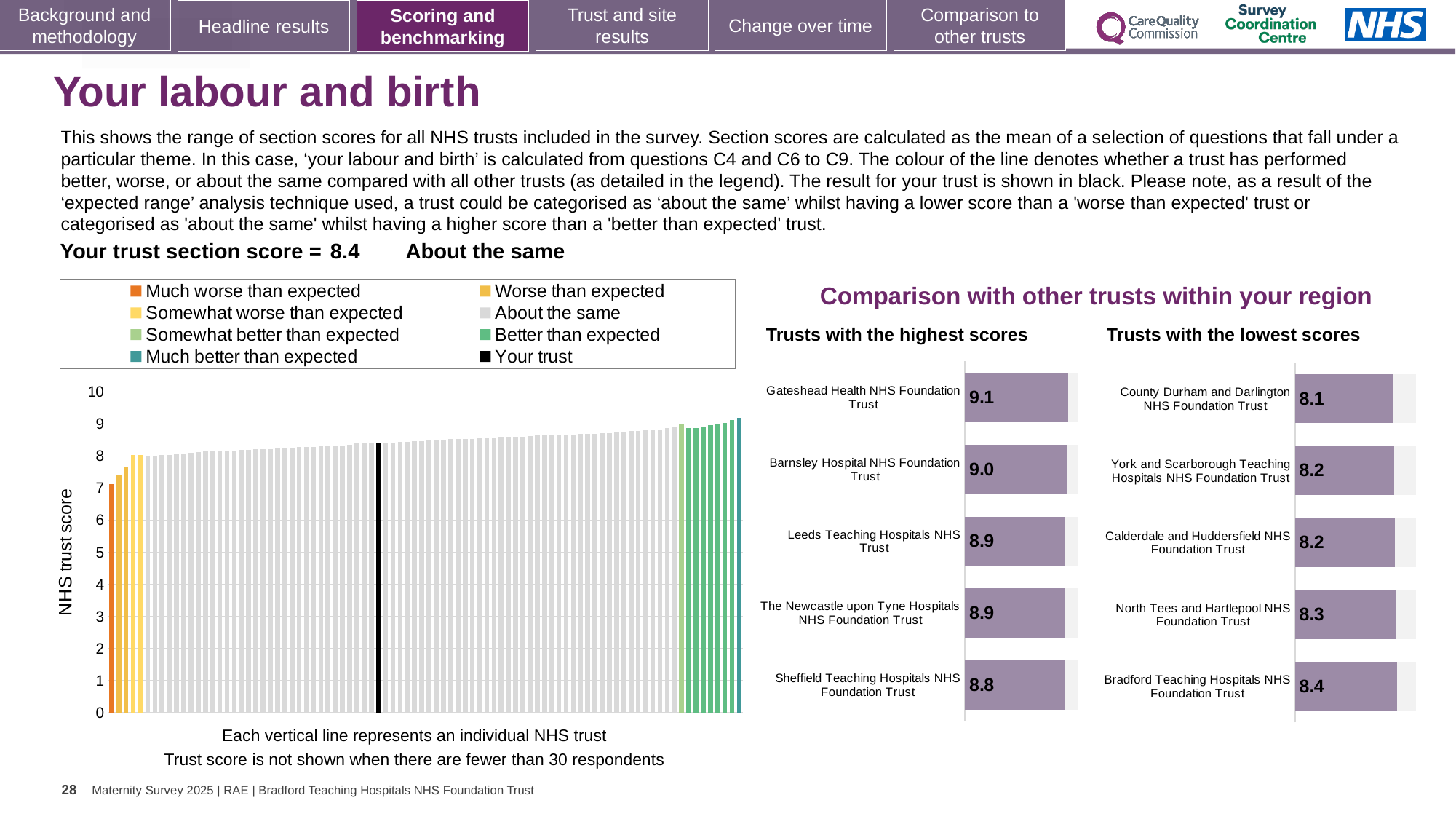
In the 'Trusts with the highest scores' chart, what is the difference between the scores of Gateshead Health NHS Foundation Trust and Sheffield Teaching Hospitals NHS Foundation Trust? 0.3 In the 'Trusts with the highest scores' chart, what is the score for Gateshead Health NHS Foundation Trust? 9.1 In the large 'NHS trust score' chart on the left, is the value of the black 'Your trust' bar greater or less than 8? greater In the 'Trusts with the lowest scores' chart, what is the difference between the scores of Bradford Teaching Hospitals NHS Foundation Trust and County Durham and Darlington NHS Foundation Trust? 0.3 How many entries does the legend of the large 'NHS trust score' chart on the left list? 8 In the 'Trusts with the highest scores' chart, what is the score for Sheffield Teaching Hospitals NHS Foundation Trust? 8.8 In the 'Trusts with the highest scores' chart, which trust has the highest score? Gateshead Health NHS Foundation Trust Which is larger: the score for Barnsley Hospital NHS Foundation Trust in the 'highest scores' chart or the score for York and Scarborough Teaching Hospitals NHS Foundation Trust in the 'lowest scores' chart? Barnsley Hospital NHS Foundation Trust In the 'Trusts with the lowest scores' chart, what is the score for North Tees and Hartlepool NHS Foundation Trust? 8.3 How many trusts are shown in the 'Trusts with the lowest scores' chart? 5 In the 'Trusts with the lowest scores' chart, which trust has the lowest score? County Durham and Darlington NHS Foundation Trust What kind of chart is the large chart on the left with the 'NHS trust score' axis? Bar chart